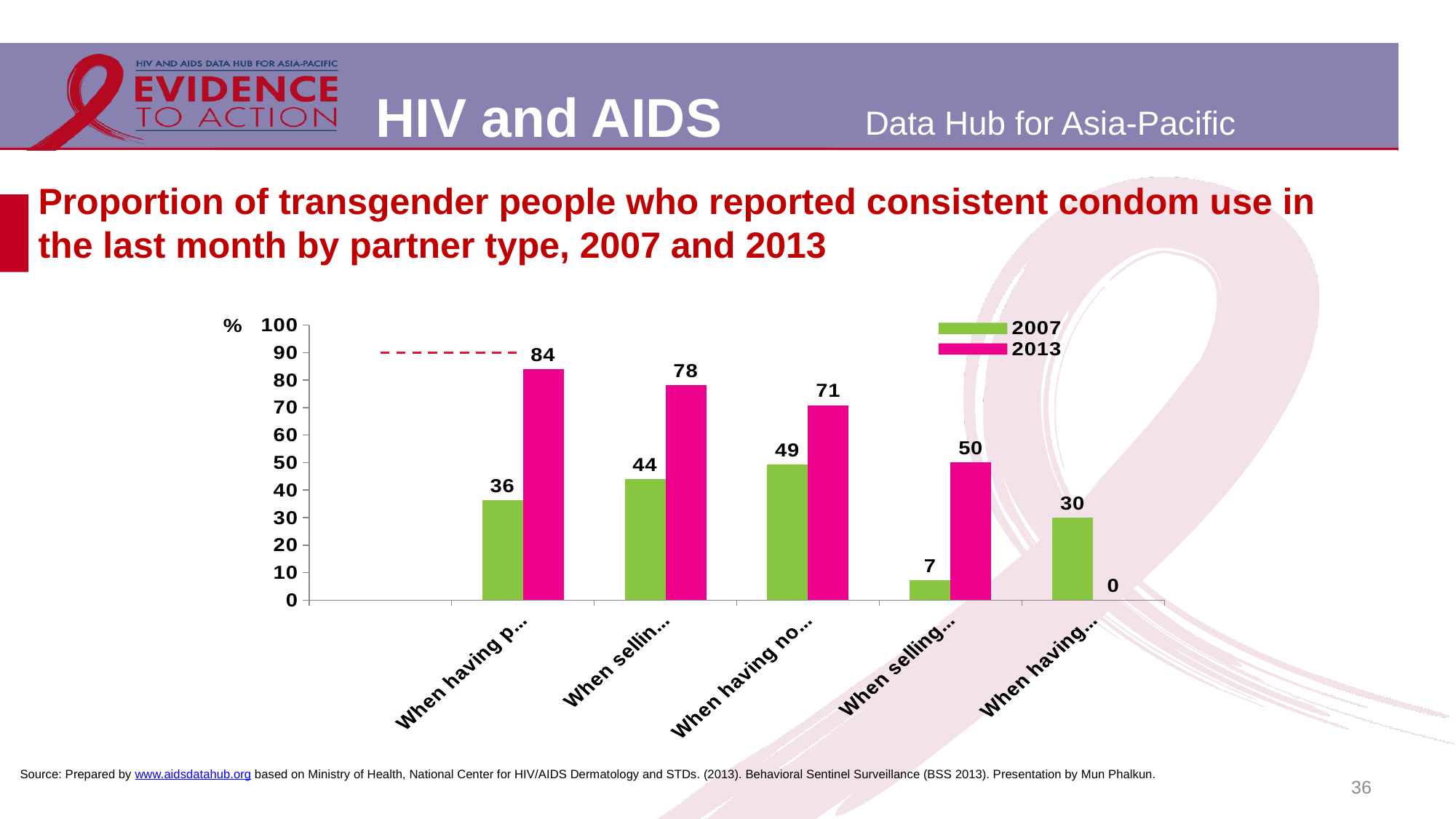
For the second category from the left, which series has the larger value, 2007 or 2013? 2013 What is the 2007 value for the first category from the left? 36 What type of chart is shown on the slide? bar chart What is the lowest value shown for the 2013 series? 0 Do the 2013 values rise or fall moving from left to right across the categories? fall What is the 2013 value for the third category from the left? 71 How many series does the chart legend list? 2 How many partner-type categories are plotted along the x axis? 5 What is the lowest value shown for the 2007 series? 7 What is the difference between the 2013 and 2007 values for the first category from the left? 48 What is the highest value shown for the 2013 series? 84 Which colour represents the 2013 series in the legend? pink